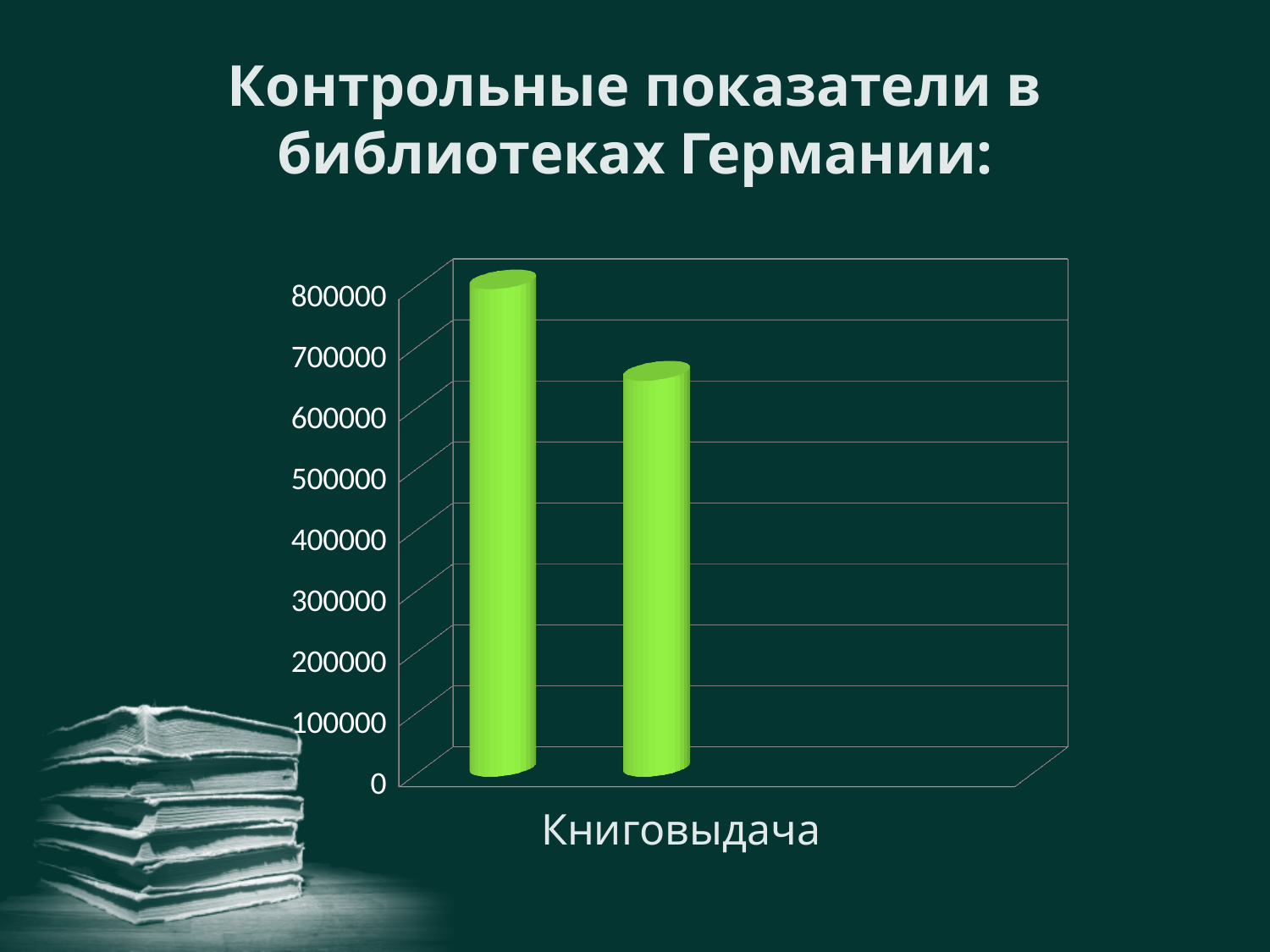
Is the value of the right bar greater or less than 700000? less How many bars are plotted in the chart? 2 Is the value of the right bar greater or less than 500000? greater What kind of chart is shown on the slide? bar chart What is the highest value shown on the vertical axis of the chart? 800000 Is the value of the left bar greater or less than 700000? greater What is the category label shown on the x axis of the chart? Книговыдача What is the title of the slide containing the chart? Контрольные показатели в библиотеках Германии: Which bar is taller, the left bar or the right bar? the left bar